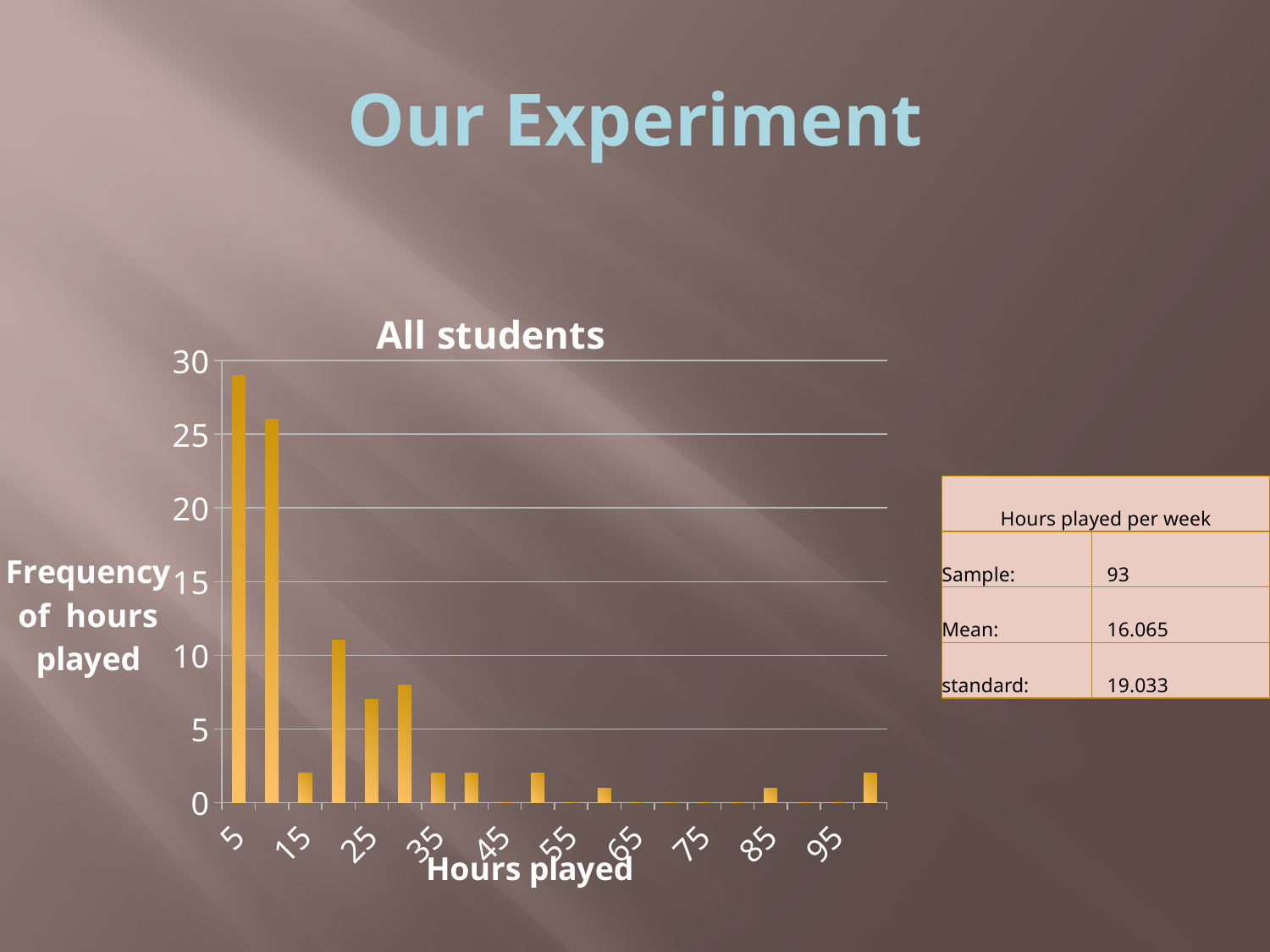
Which hours-played category has the highest frequency? 5 What is the label on the x axis of the chart? Hours played Is the frequency for 5 hours played greater or less than 25? greater What is the title of the chart? All students Is the frequency for 25 hours played greater or less than 5? greater Is the frequency for 95 hours played greater or less than 5? less Which has the higher frequency, 5 hours played or 15 hours played? 5 Do the frequencies generally rise or fall as hours played increases along the x axis? fall Which has the higher frequency, 25 hours played or 35 hours played? 25 What kind of chart is shown on the slide? bar chart